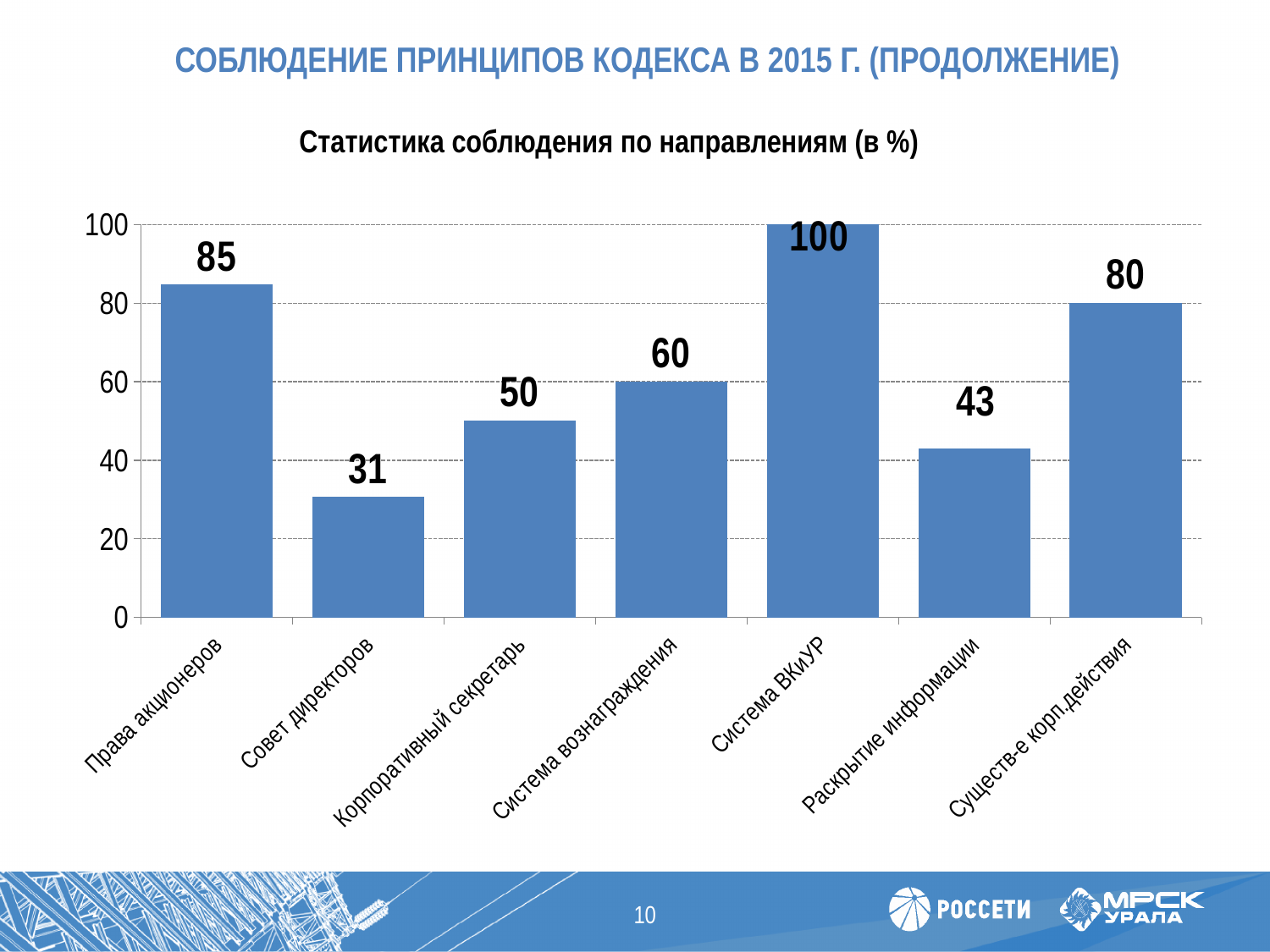
Which is larger, the value for Система вознаграждения or the value for Корпоративный секретарь? Система вознаграждения What kind of chart is shown on the slide? bar chart What is the difference between the values for Права акционеров and Существ-е корп.действия? 5 What is the value for Существ-е корп.действия? 80 Which category has the highest value? Система ВКиУР What is the value for Права акционеров? 85 What is the difference between the values for Система ВКиУР and Совет директоров? 69 Is the value for Раскрытие информации greater or less than 60? less How many categories are shown on the chart? 7 What is the value for Совет директоров? 31 What is the value for Раскрытие информации? 43 Which category has the lowest value? Совет директоров